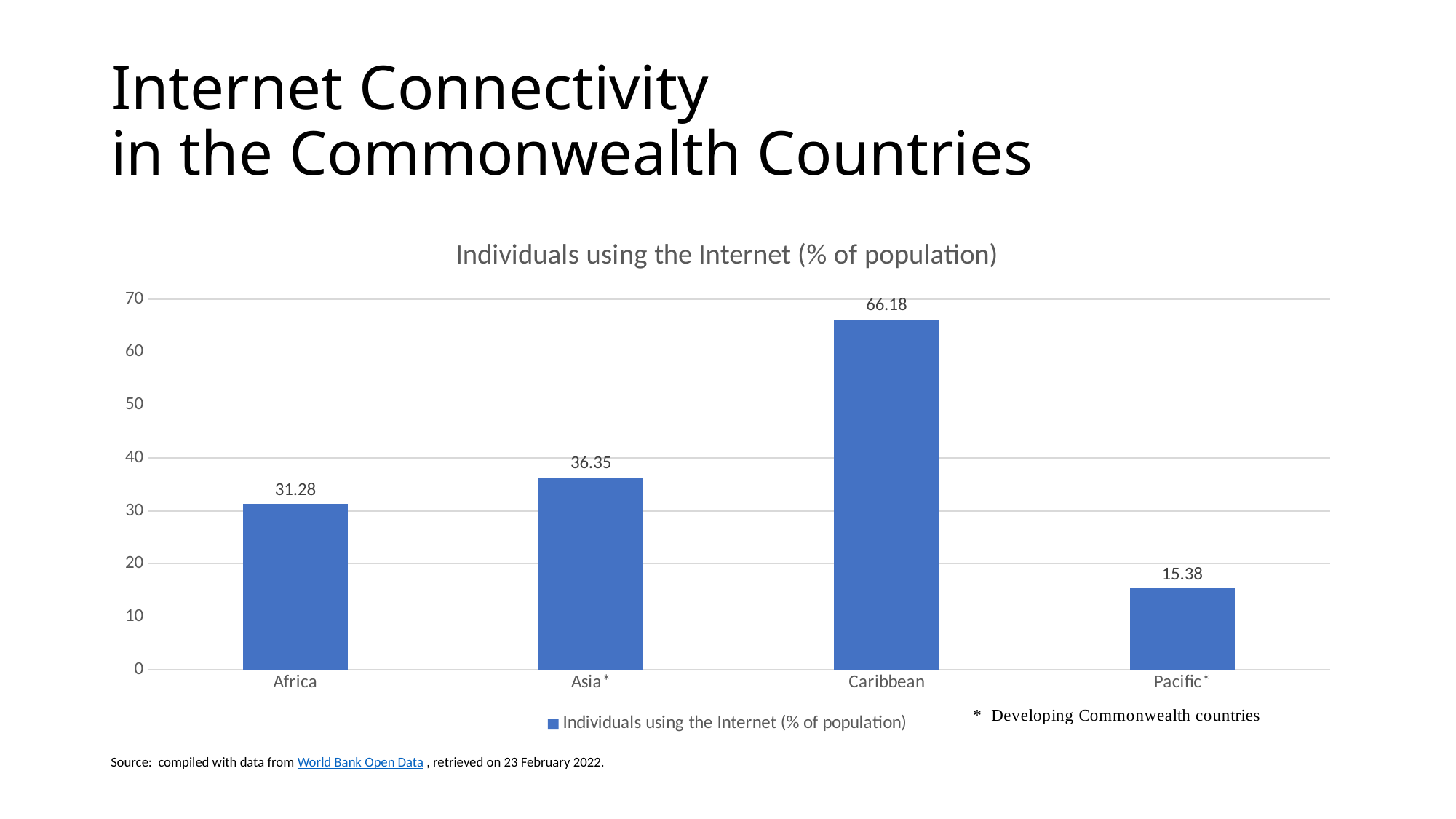
What is the value for Caribbean? 66.18 What is the value for Asia*? 36.35 What is the value for Pacific*? 15.38 What is the title of the chart? Individuals using the Internet (% of population) What is the difference between the values for Caribbean and Africa? 34.9 What kind of chart is shown? Bar chart What is the value for Africa? 31.28 Which category has the lowest value? Pacific* Which category has the highest value? Caribbean Which is larger, the value for Asia* or the value for Africa? Asia* Is the value for Caribbean greater or less than 60? greater How many categories are shown on the x axis? 4